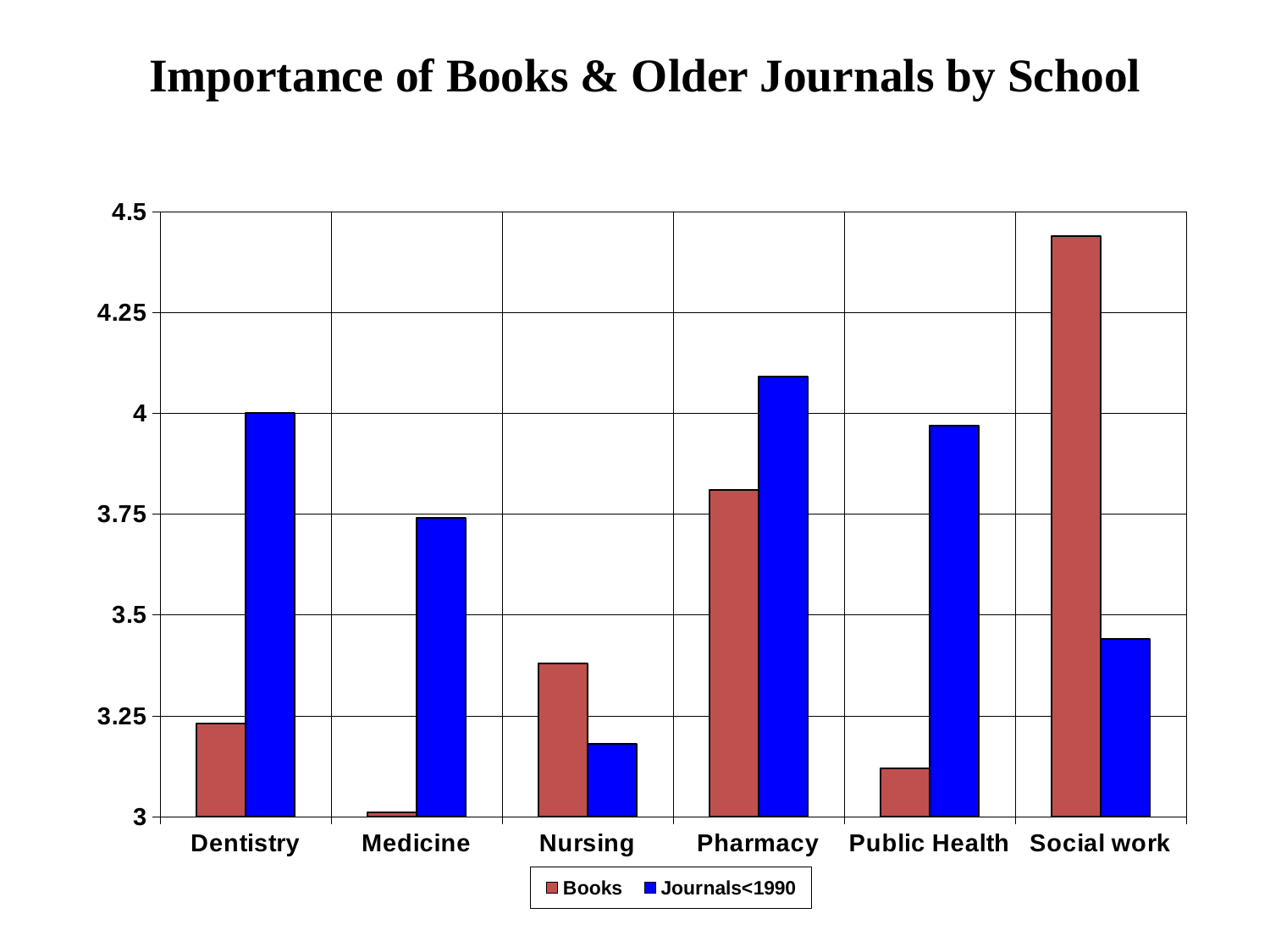
Is the value for Books in Public Health greater or less than 3.25? less How many schools are shown on the x axis? 6 Which school has the highest value for Books? Social work Is the value for Books in Social work greater or less than 4.25? greater For Nursing, which is larger: Books or Journals<1990? Books How many series does the legend list? 2 Is the value for Journals<1990 in Medicine greater or less than 3.5? greater Which school has the lowest value for Journals<1990? Nursing Which school has the highest value for Journals<1990? Pharmacy What kind of chart is shown on the slide? bar chart Which school has the lowest value for Books? Medicine What is the title of the chart? Importance of Books & Older Journals by School